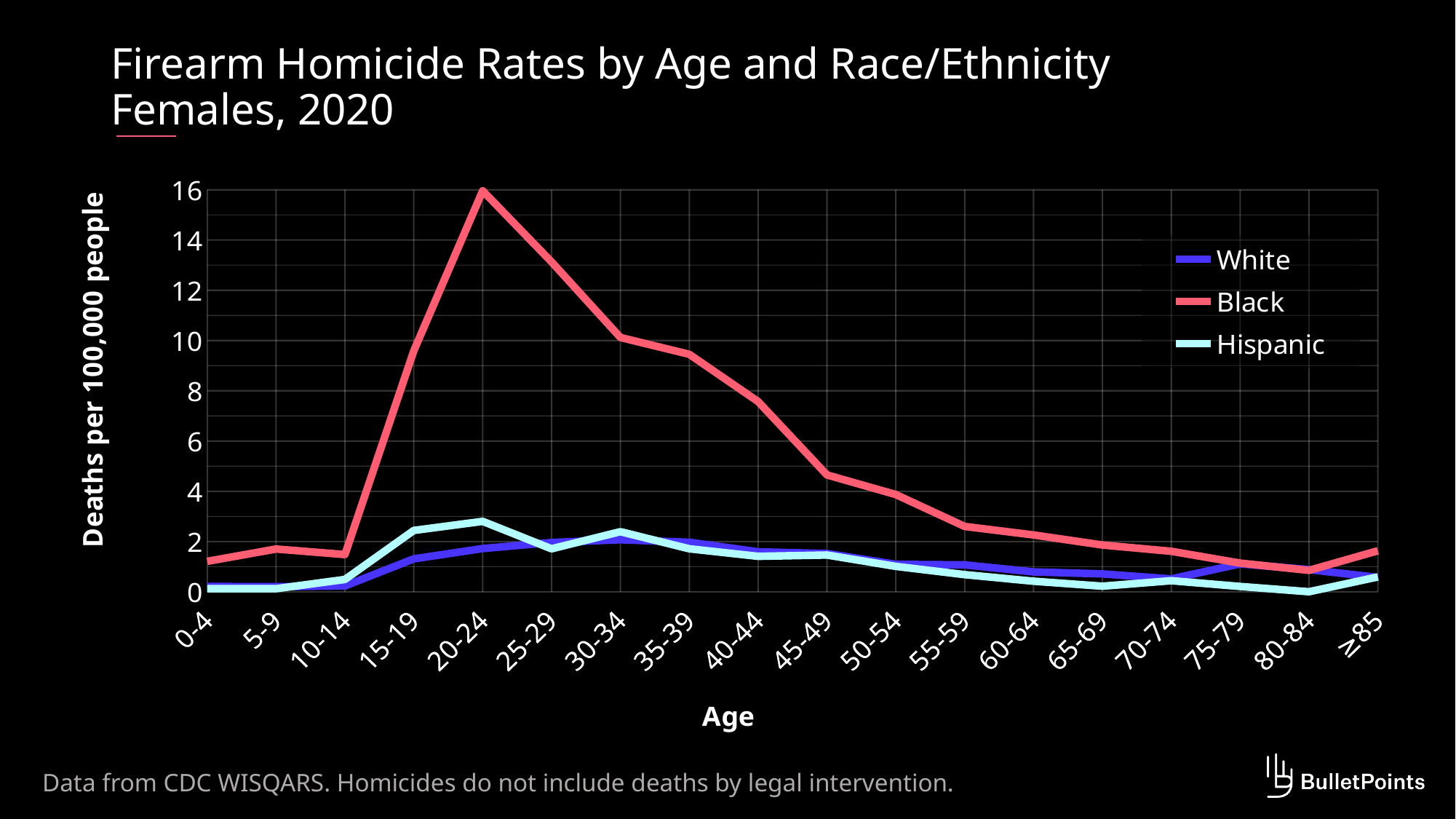
Is the value for Black females aged 55-59 greater or less than 4? less What kind of chart is shown on the slide? Line chart How many series does the legend list? 3 Is the value for White females aged 0-4 greater or less than 2? less Which age group has the highest firearm homicide rate for Black females? 20-24 Is the value for Black females aged 20-24 greater or less than 14? greater What is the label on the y axis? Deaths per 100,000 people How many age groups are shown along the x axis? 18 Does the Black series rise or fall from age 20-24 to age 80-84? Fall At age 15-19, which series has the larger value, Hispanic or White? Hispanic At age 20-24, which series has the larger value, Black or Hispanic? Black